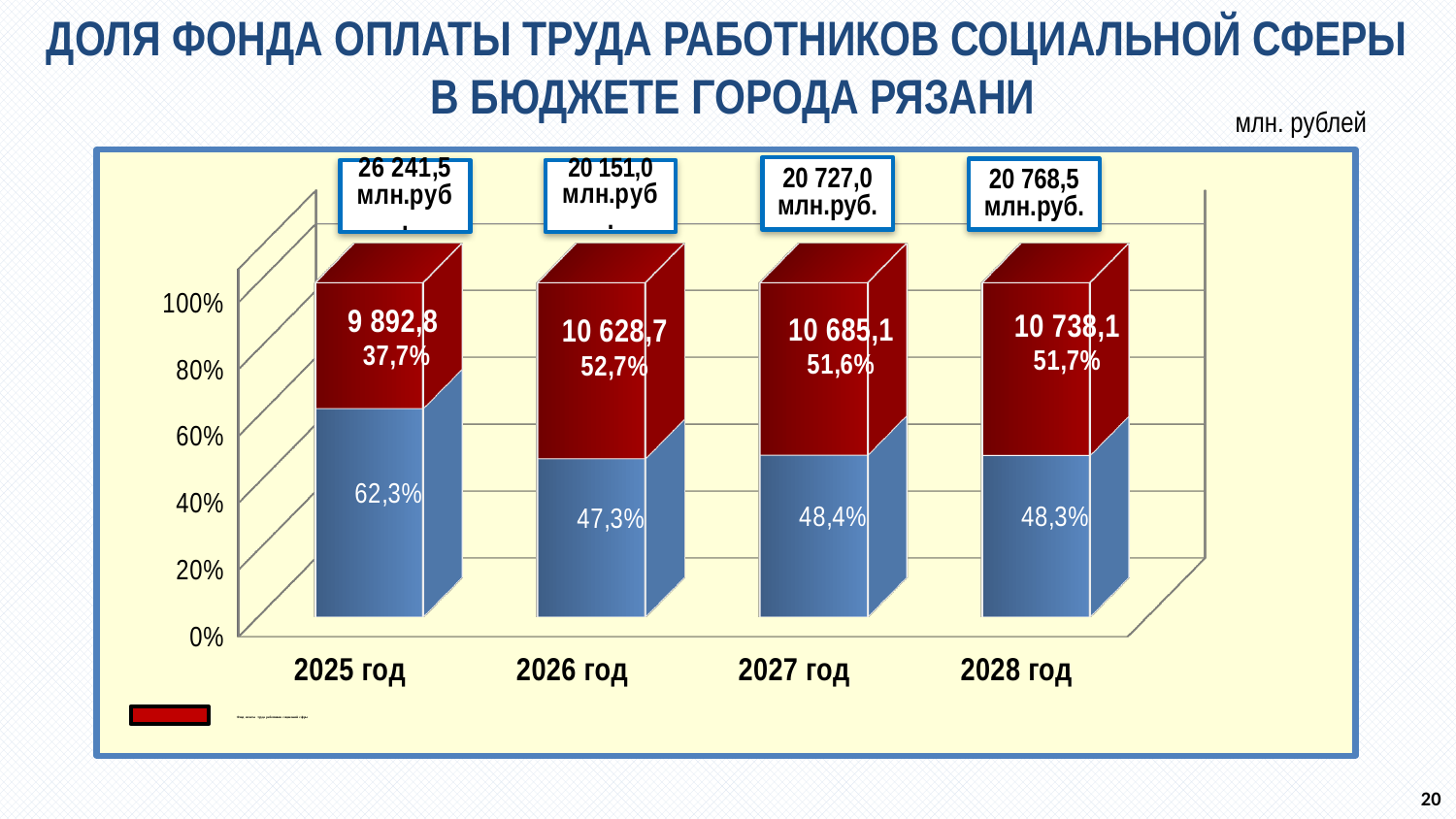
What total is printed in the box above the bar for 2028 год? 20 768,5 млн.руб. What percentage is printed on the red segment for 2026 год? 52,7% Which year has the highest value printed on the red segment? 2028 год Which year has the lowest percentage printed on the red segment? 2025 год What total is printed in the box above the bar for 2025 год? 26 241,5 млн.руб. How many years are shown on the x axis? 4 What is the value printed on the red segment for 2025 год? 9 892,8 What kind of chart is shown on the slide? Stacked bar chart Which has the larger red segment value, 2026 год or 2027 год? 2027 год What percentage is printed on the blue segment for 2027 год? 48,4% Do the values printed on the red segments rise or fall from 2025 год to 2028 год? Rise What is the difference between the red segment values for 2028 год and 2025 год? 845,3